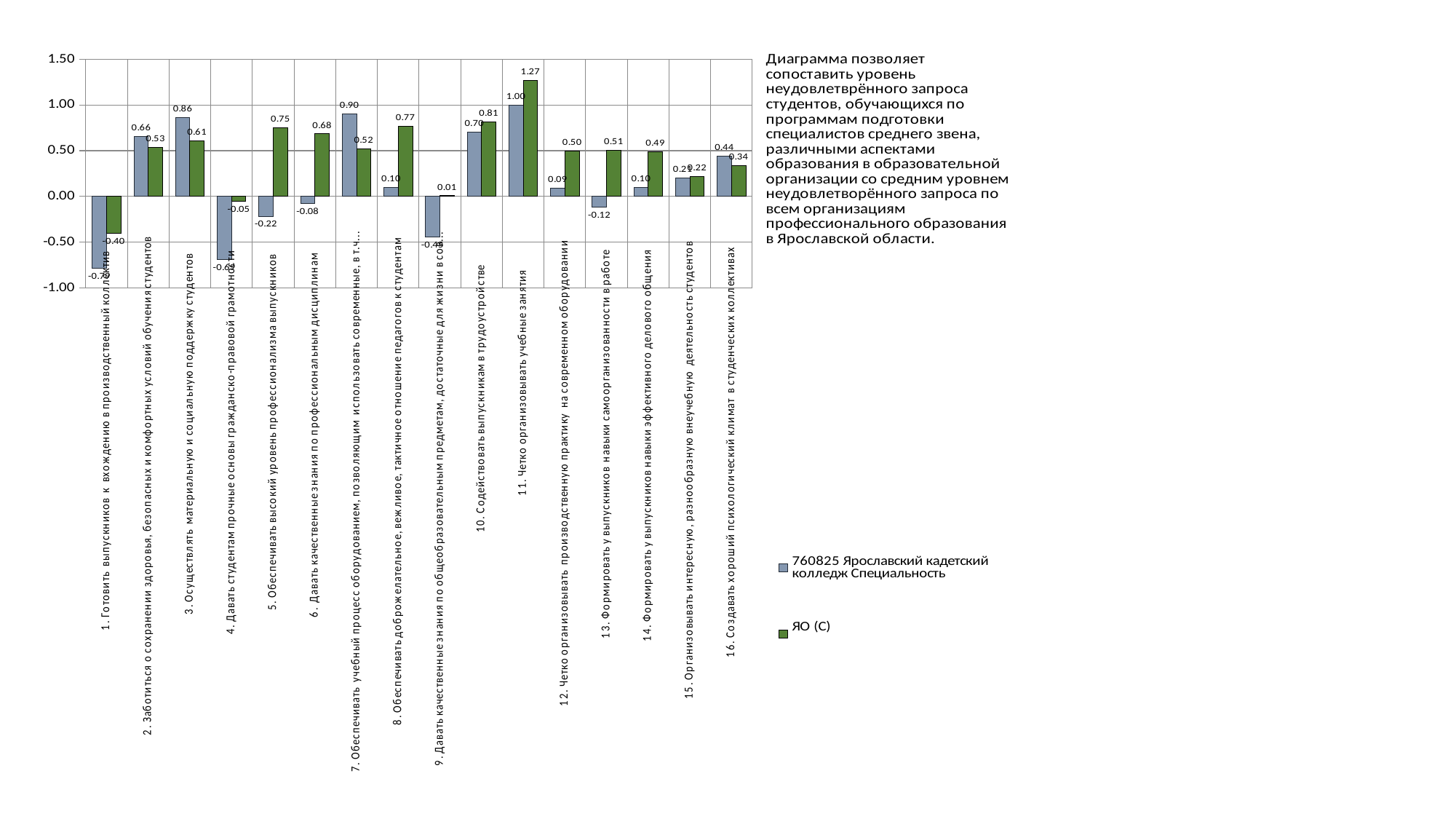
Is the value of the 760825 Ярославский кадетский колледж Специальность series for category 1 greater or less than -0.50? less How many categories are plotted along the x axis? 16 What is the value of the ЯО (С) series for category 11 (Четко организовывать учебные занятия)? 1.27 What is the value of the ЯО (С) series for category 9? 0.01 What kind of chart is shown on the slide? bar chart Which category has the lowest value in the ЯО (С) series? 1. Готовить выпускников к вхождению в производственный коллектив What is the value of the 760825 Ярославский кадетский колледж Специальность series for category 13 (Формировать у выпускников навыки самоорганизованности в работе)? -0.12 For category 7, which series has the larger value: 760825 Ярославский кадетский колледж Специальность or ЯО (С)? 760825 Ярославский кадетский колледж Специальность How many series does the legend list? 2 Which category has the highest value in the ЯО (С) series? 11. Четко организовывать учебные занятия What is the value of the 760825 Ярославский кадетский колледж Специальность series for category 3 (Осуществлять материальную и социальную поддержку студентов)? 0.86 For category 11, what is the difference between the ЯО (С) value and the 760825 Ярославский кадетский колледж Специальность value? 0.27